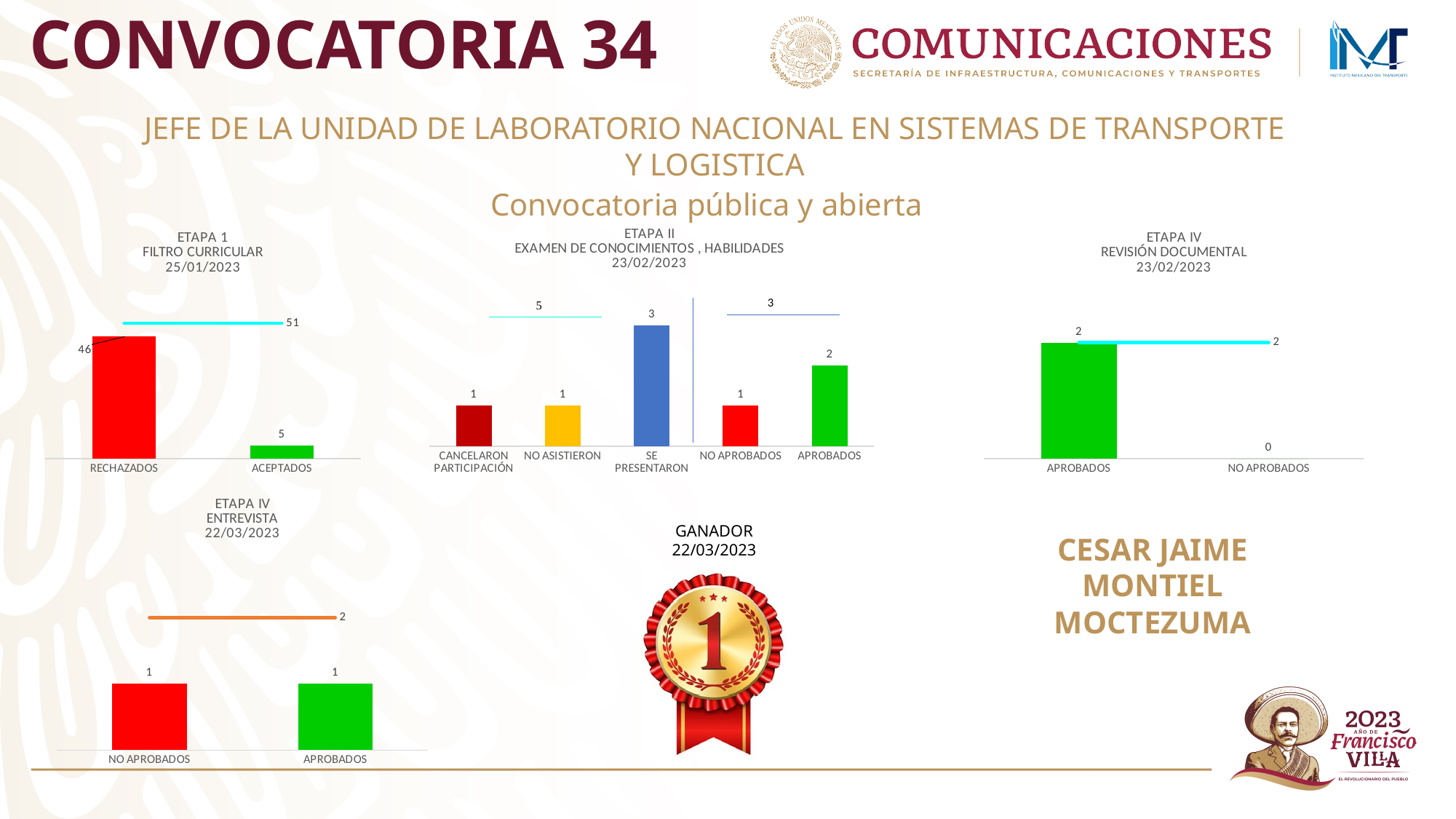
In the ETAPA IV ENTREVISTA chart, what is the value for APROBADOS? 1 In the ETAPA IV REVISIÓN DOCUMENTAL chart, which category is lowest? NO APROBADOS In the ETAPA 1 FILTRO CURRICULAR chart, which category is highest? RECHAZADOS In the ETAPA II EXAMEN DE CONOCIMIENTOS, HABILIDADES chart, how many categories are shown on the x axis? 5 In the ETAPA II EXAMEN DE CONOCIMIENTOS, HABILIDADES chart, which is larger, APROBADOS or NO APROBADOS? APROBADOS In the ETAPA IV REVISIÓN DOCUMENTAL chart, what is the value for NO APROBADOS? 0 In the ETAPA 1 FILTRO CURRICULAR chart, what is the value for ACEPTADOS? 5 In the ETAPA II EXAMEN DE CONOCIMIENTOS, HABILIDADES chart, what is the value for APROBADOS? 2 What kind of chart is the ETAPA IV ENTREVISTA chart? Combination bar and line chart In the ETAPA 1 FILTRO CURRICULAR chart, what is the difference between RECHAZADOS and ACEPTADOS? 41 In the ETAPA II EXAMEN DE CONOCIMIENTOS, HABILIDADES chart, what is the value for SE PRESENTARON? 3 In the ETAPA 1 FILTRO CURRICULAR chart, what is the value for RECHAZADOS? 46